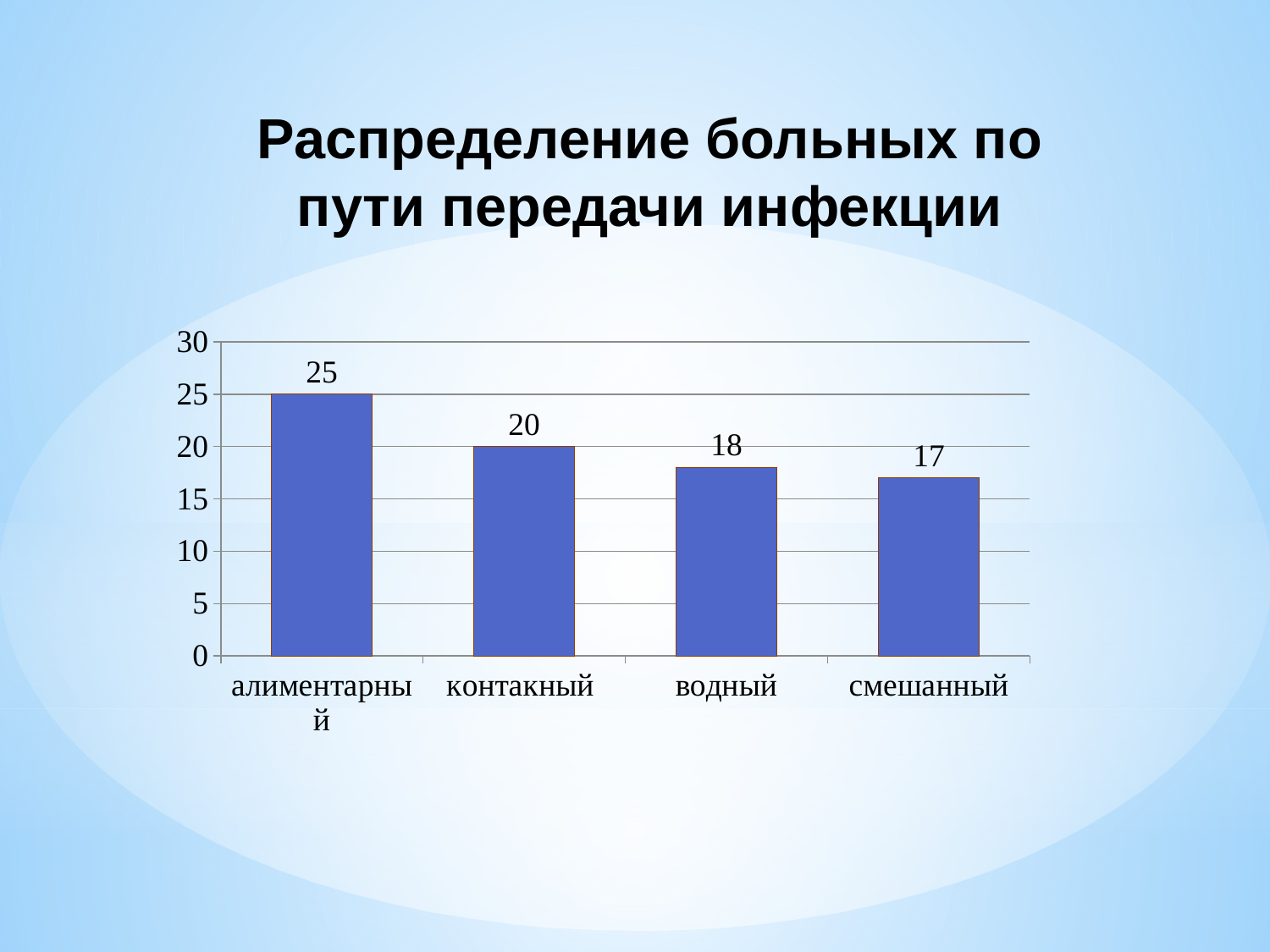
What is the difference between the values for алиментарный and контакный? 5 Which is larger, the value for контакный or the value for водный? контакный What is the value for контакный? 20 Which category has the lowest value? смешанный What is the difference between the values for водный and смешанный? 1 What is the value for смешанный? 17 What is the value for алиментарный? 25 Do the values rise or fall from left to right along the x axis? fall What is the value for водный? 18 How many categories are shown on the x axis? 4 Which category has the highest value? алиментарный What kind of chart is shown on the slide? bar chart